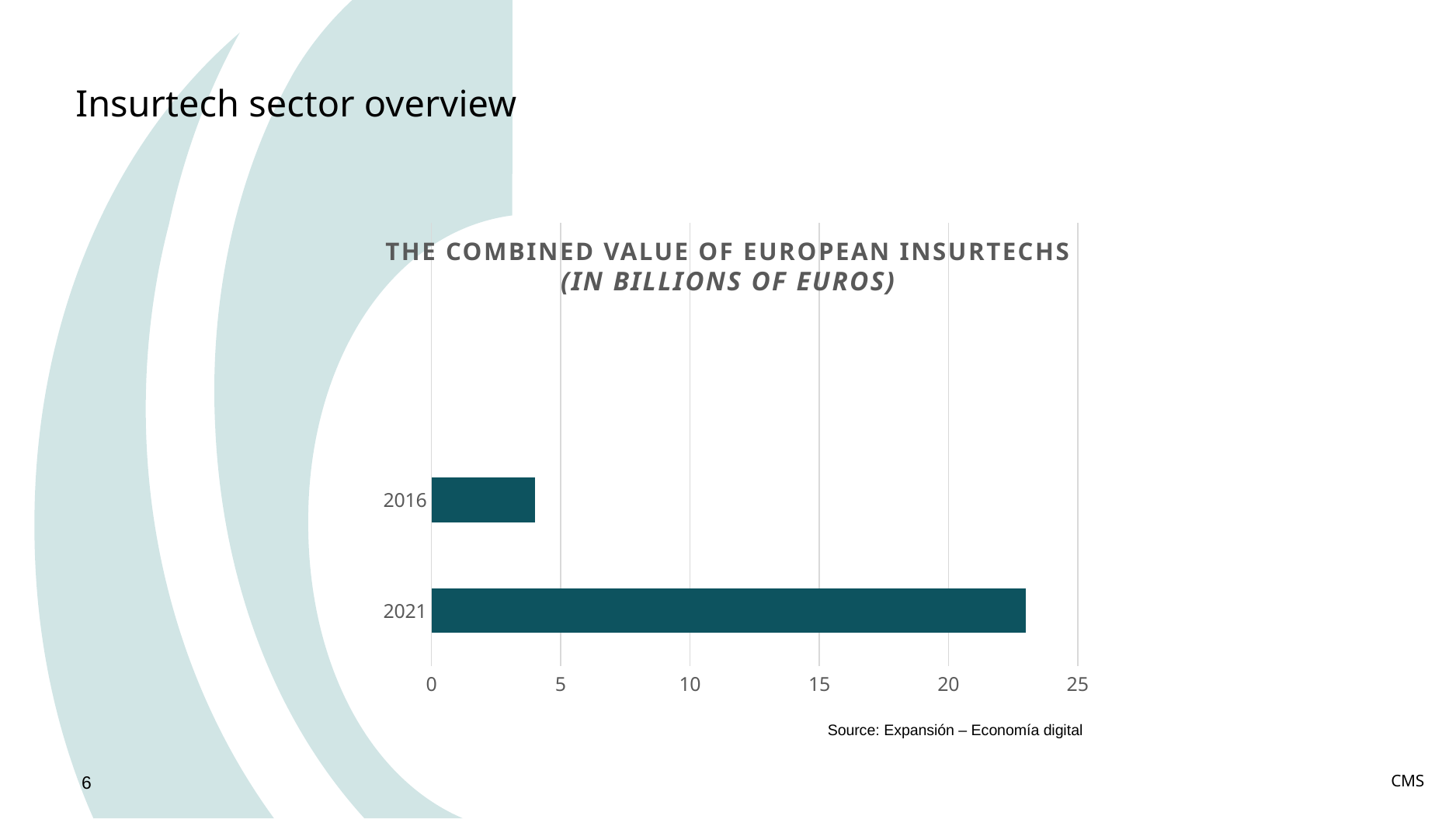
Is the value for 2021 greater or less than 20? greater Is the value for 2016 greater or less than 5? less What kind of chart is shown on the slide? bar chart Which year has the highest combined value of European insurtechs? 2021 How many categories (years) are plotted in the chart? 2 What is the maximum value shown on the horizontal axis of the chart? 25 Which is larger, the value for 2016 or the value for 2021? 2021 What is the title of the chart? The combined value of European insurtechs (in billions of euros) Is the value for 2021 greater or less than 25? less Which year has the lowest combined value of European insurtechs? 2016